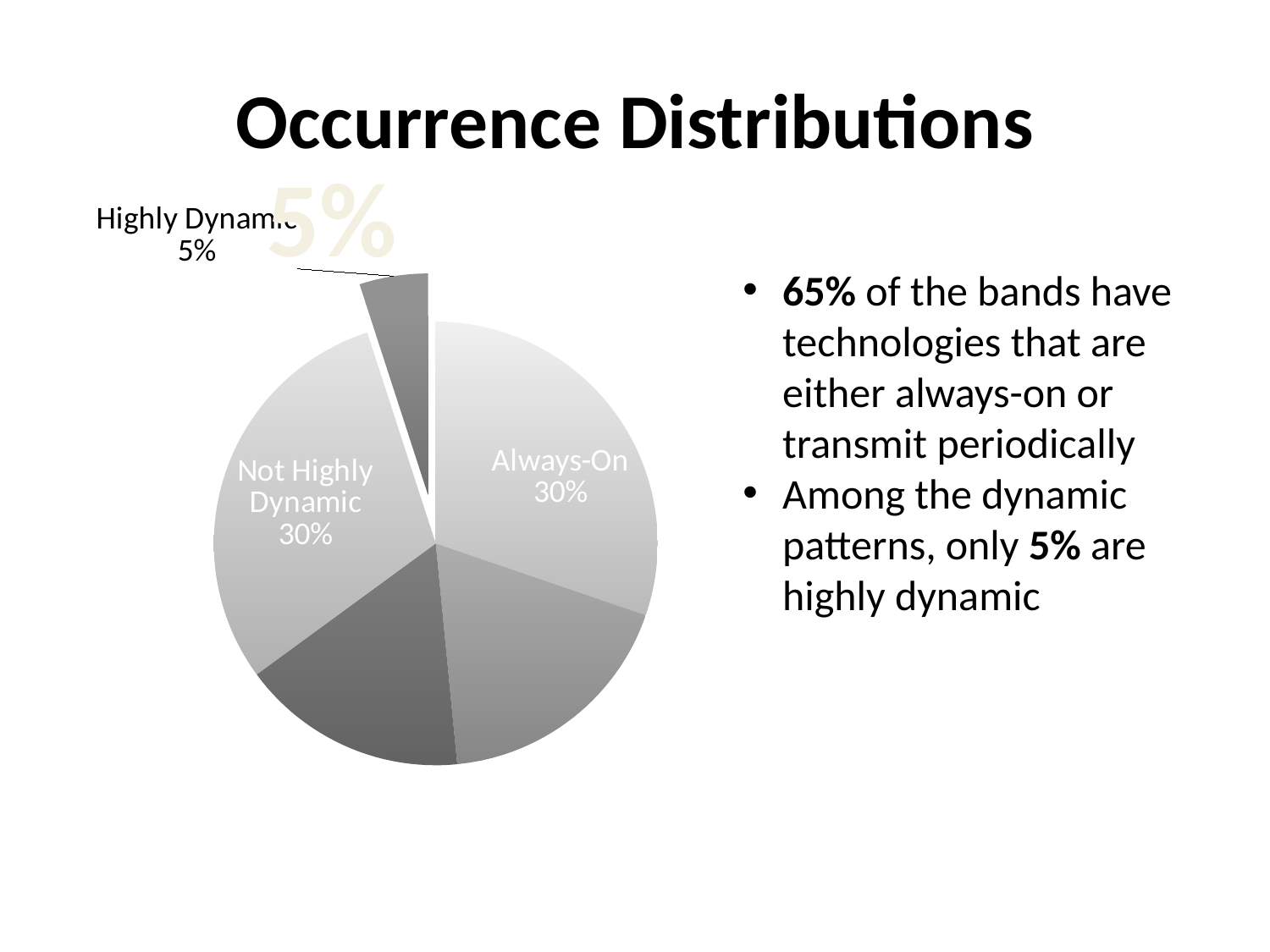
What share of the pie is labelled Highly Dynamic? 5% What is the difference between the Always-On share and the Highly Dynamic share? 25% Which is larger, the Not Highly Dynamic slice or the Highly Dynamic slice? Not Highly Dynamic Which is larger, the Always-On slice or the Highly Dynamic slice? Always-On Which slice of the pie chart is pulled out from the rest of the pie? Highly Dynamic How many slices does the pie chart have? 5 What share of the pie is labelled Always-On? 30% Which labelled slice of the pie chart is the smallest? Highly Dynamic What is the title of the slide containing the pie chart? Occurrence Distributions What share of the pie is labelled Not Highly Dynamic? 30% What kind of chart is shown on the slide? pie chart